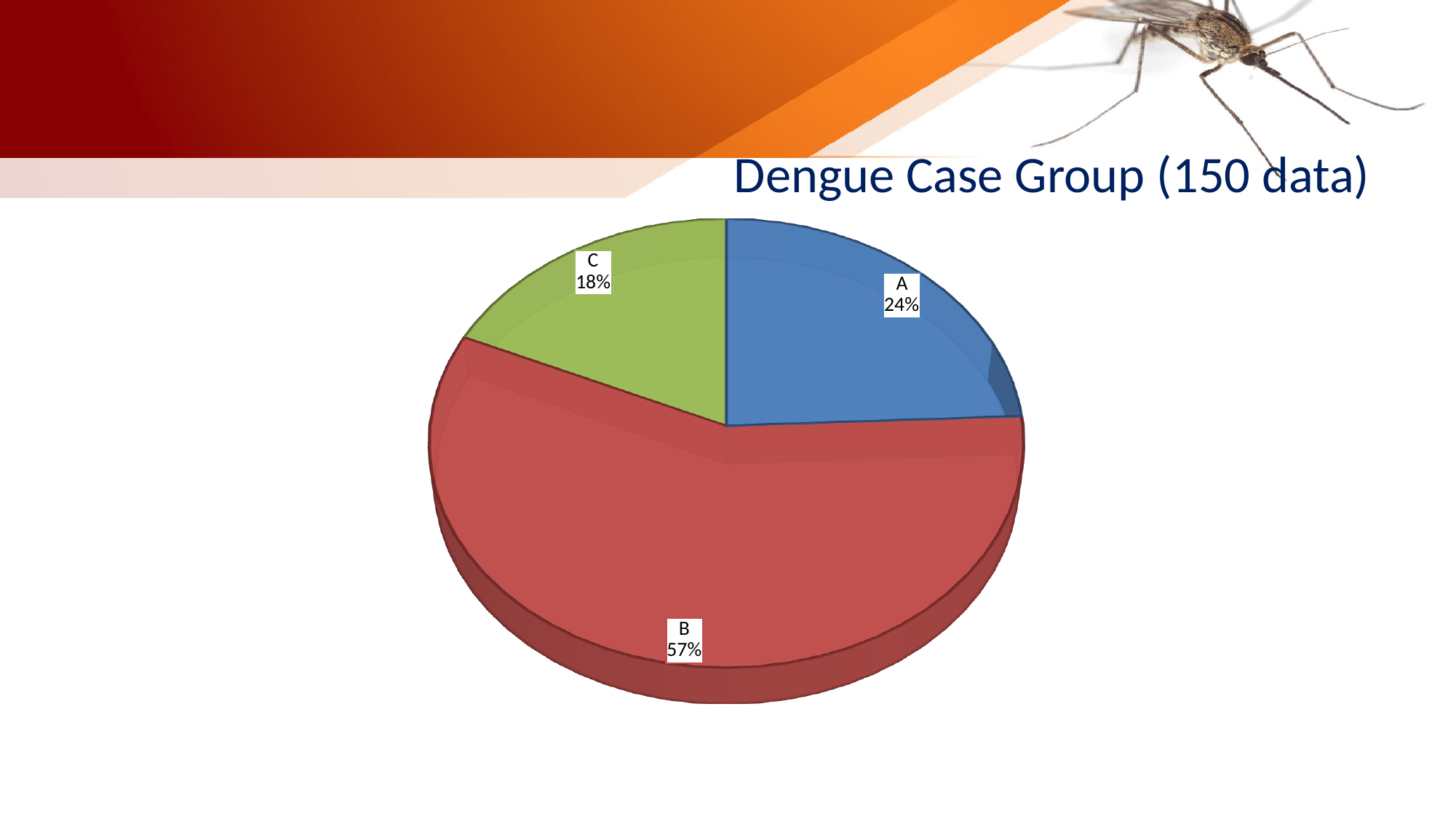
Which group has the largest share of the pie? B What kind of chart is shown on the slide? Pie chart What is the difference in percentage points between group B and group A? 33 Which group has a larger share, A or C? A What share of the pie does group A represent? 24% What share of the pie does group B represent? 57% What is the difference in percentage points between group A and group C? 6 What colour is the slice for group B? Red Which group has the smallest share of the pie? C What share of the pie does group C represent? 18% How many groups are shown in the pie chart? 3 What is the title of the chart? Dengue Case Group (150 data)